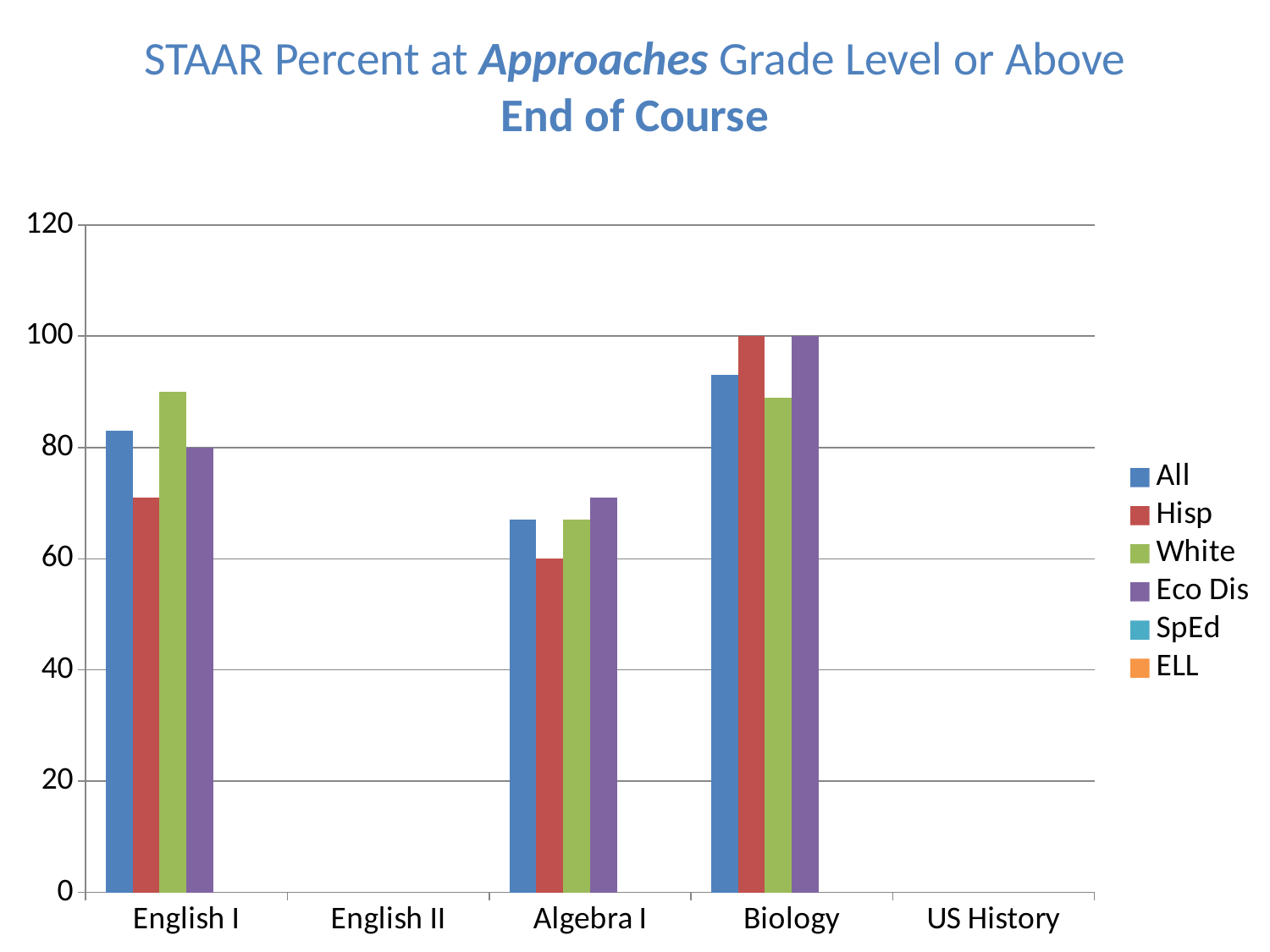
Which is larger for English I, the All bar or the Hisp bar? All What kind of chart is shown on the slide? bar chart How many course categories are shown on the x axis? 5 What is the value for Hisp in Biology? 100 Is the value for White in Biology greater or less than 100? less What is the last entry in the legend? ELL How many series does the legend list? 6 Which series has the lowest bar for English I? Hisp Is the value for Hisp in English I greater or less than 80? less Which series has the lowest bar for Algebra I? Hisp Which series has the highest bar for English I? White Is the value for White in English I greater or less than 80? greater